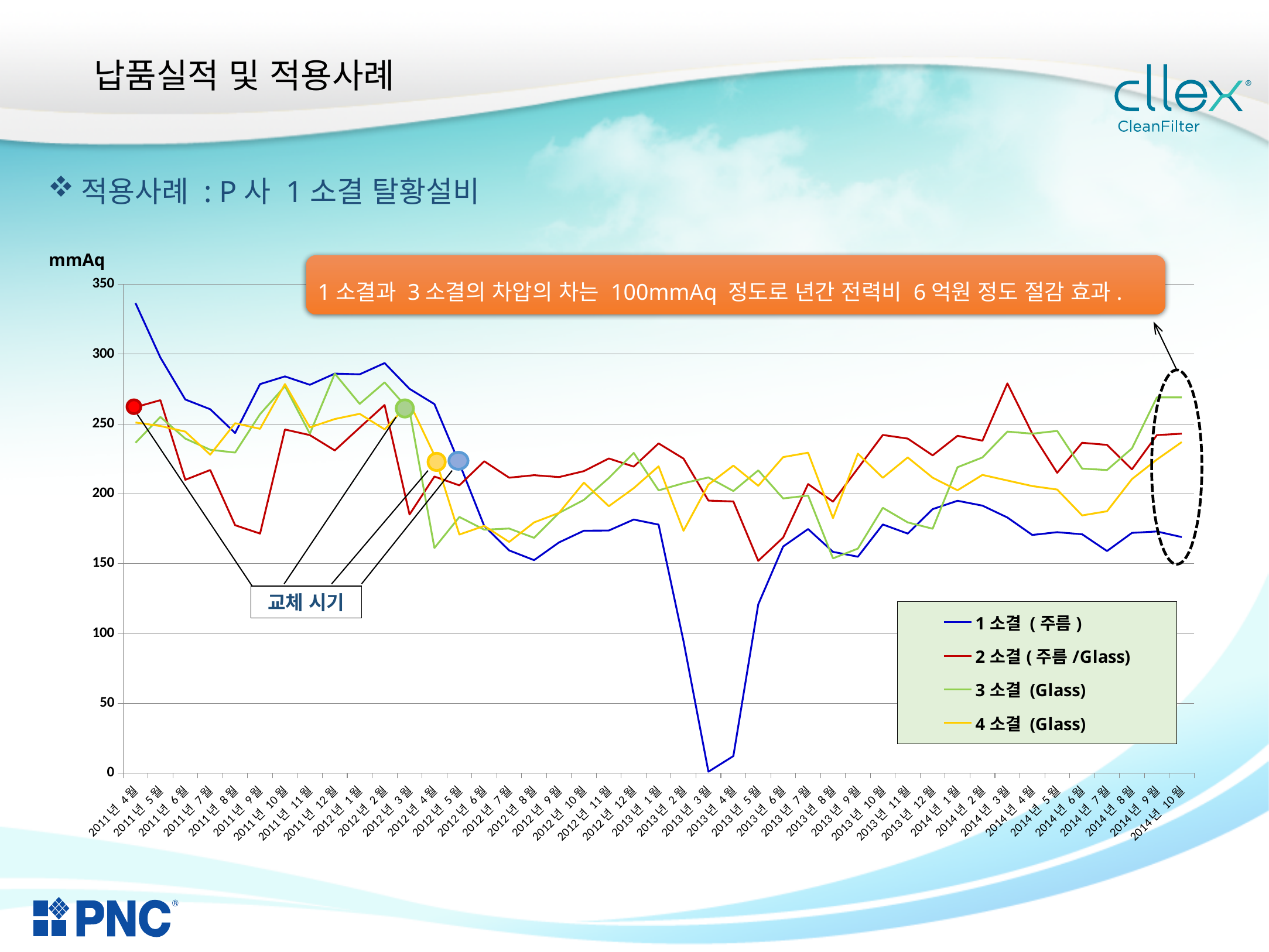
Is the value for 3 소결 (Glass) at 2014년 9월 greater or less than 250? greater Does the 1 소결 ( 주름 ) series rise or fall from 2011년 4월 to 2011년 8월? fall How many series does the legend list? 4 Is the value for 2 소결 ( 주름 /Glass) at 2014년 3월 greater or less than 250? greater What kind of chart is shown on the slide? line chart Which series is drawn in blue according to the legend? 1 소결 ( 주름 ) At 2014년 10월, which is larger: the value for 3 소결 (Glass) or the value for 1 소결 ( 주름 )? 3 소결 (Glass) Is the value for 1 소결 ( 주름 ) at 2014년 10월 greater or less than 200? less At which month does the 1 소결 ( 주름 ) series reach its lowest value? 2013년 3월 What unit is shown for the y axis of the chart? mmAq